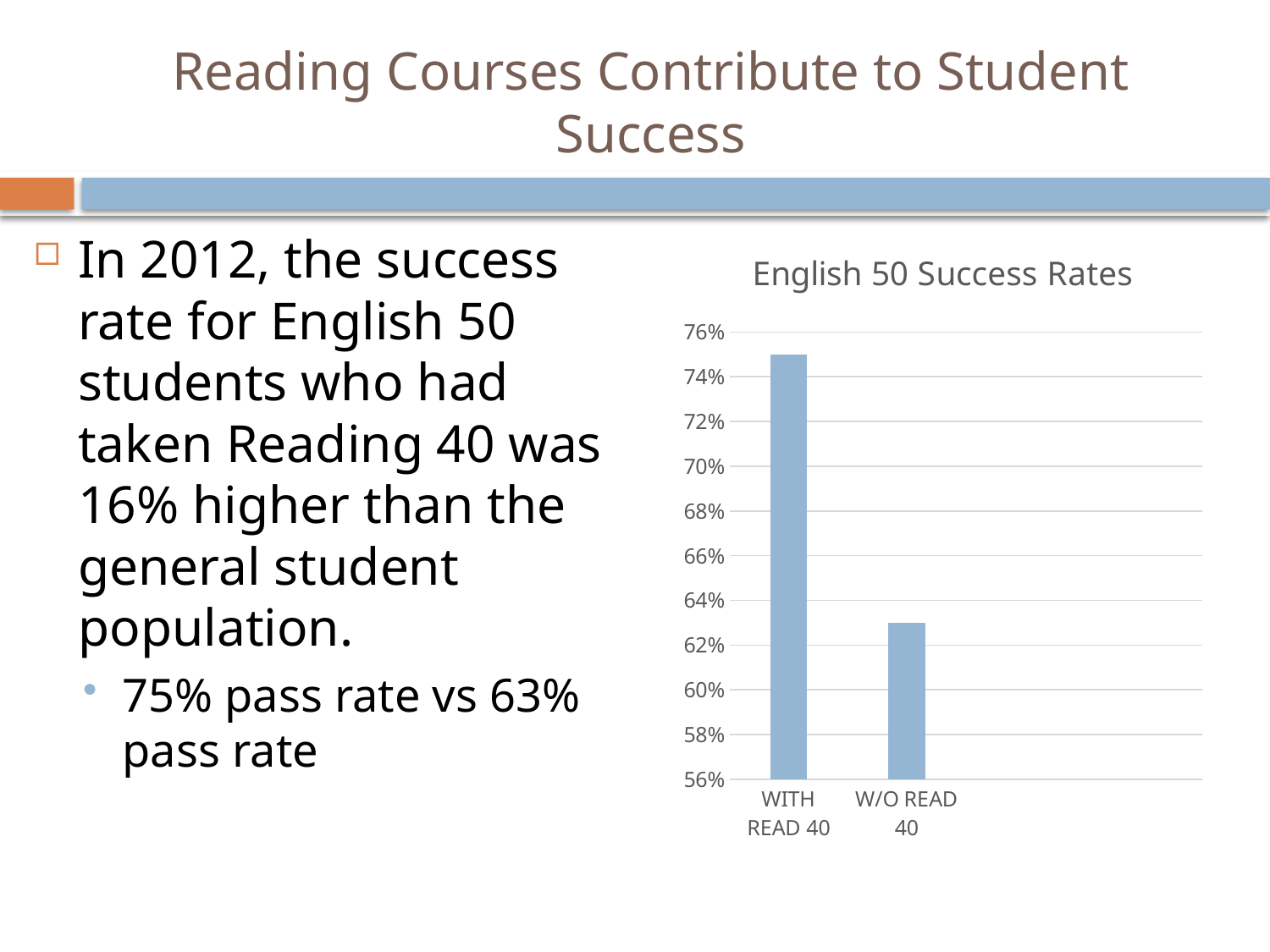
What is the title of the chart? English 50 Success Rates What is the success rate for W/O READ 40, as stated on the slide? 63% How many categories are plotted in the chart? 2 What type of chart is shown on the slide? bar chart Which category has the highest success rate in the chart? WITH READ 40 What is the success rate for WITH READ 40, as stated on the slide? 75% Which is larger, the success rate for WITH READ 40 or for W/O READ 40? WITH READ 40 By how many percentage points does the WITH READ 40 pass rate exceed the W/O READ 40 pass rate? 12 percentage points Is the value for W/O READ 40 greater or less than 66%? less Which category has the lowest success rate in the chart? W/O READ 40 Is the value for WITH READ 40 greater or less than 70%? greater What is the lowest value shown on the chart's vertical axis? 56%